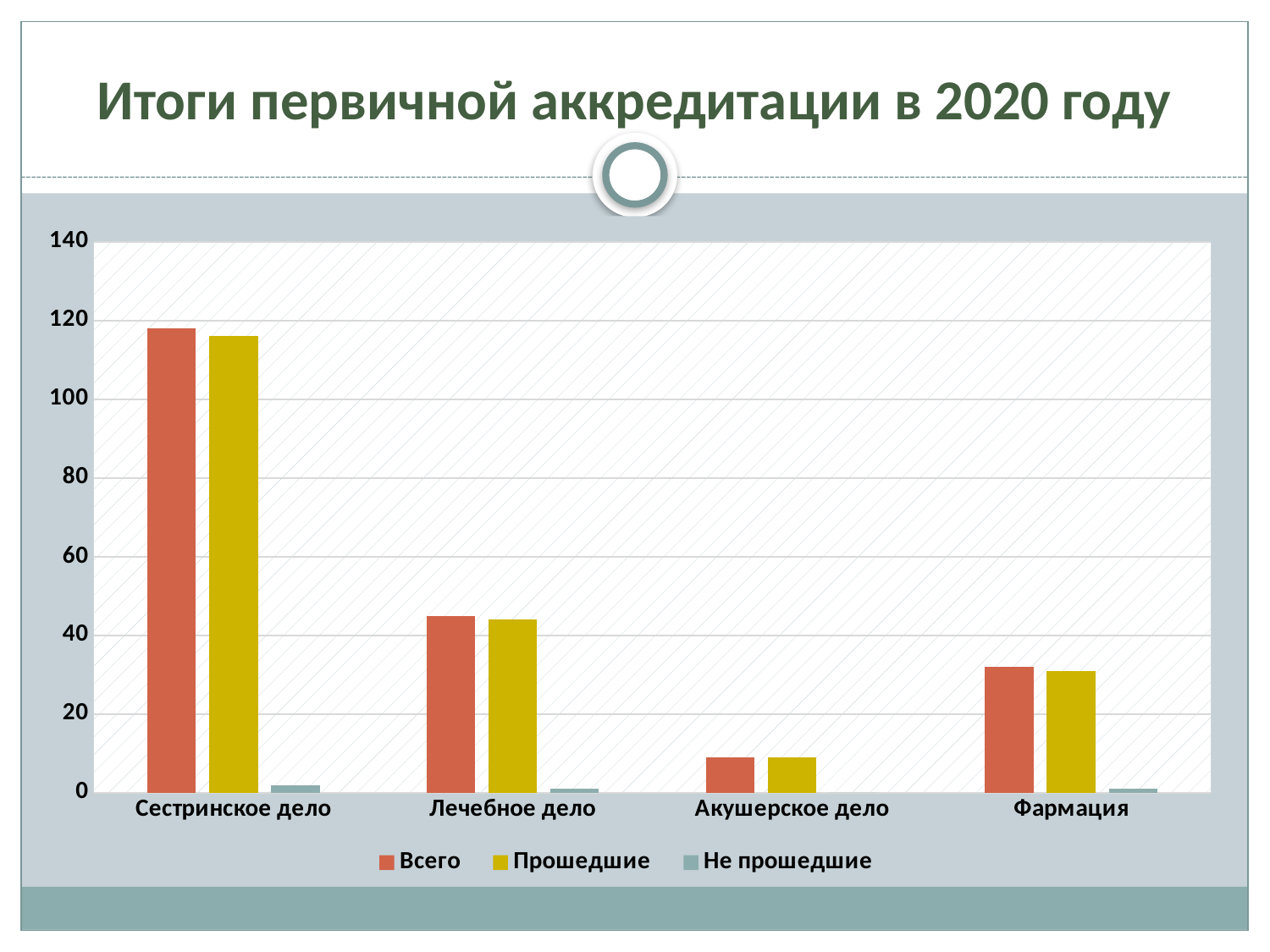
Is the value for Прошедшие in Фармация greater or less than 40? less What kind of chart is shown on the slide? bar chart Is the value for Всего in Акушерское дело greater or less than 20? less Which category has the lowest value for Всего? Акушерское дело Is the value for Всего in Сестринское дело greater or less than 100? greater How many categories are shown on the x axis of the chart? 4 What is the title of the slide containing the chart? Итоги первичной аккредитации в 2020 году How many series does the chart's legend list? 3 Which category has the highest value for Всего? Сестринское дело Which is larger, the Всего value for Лечебное дело or the Всего value for Фармация? Лечебное дело Which series in the legend is shown in yellow? Прошедшие